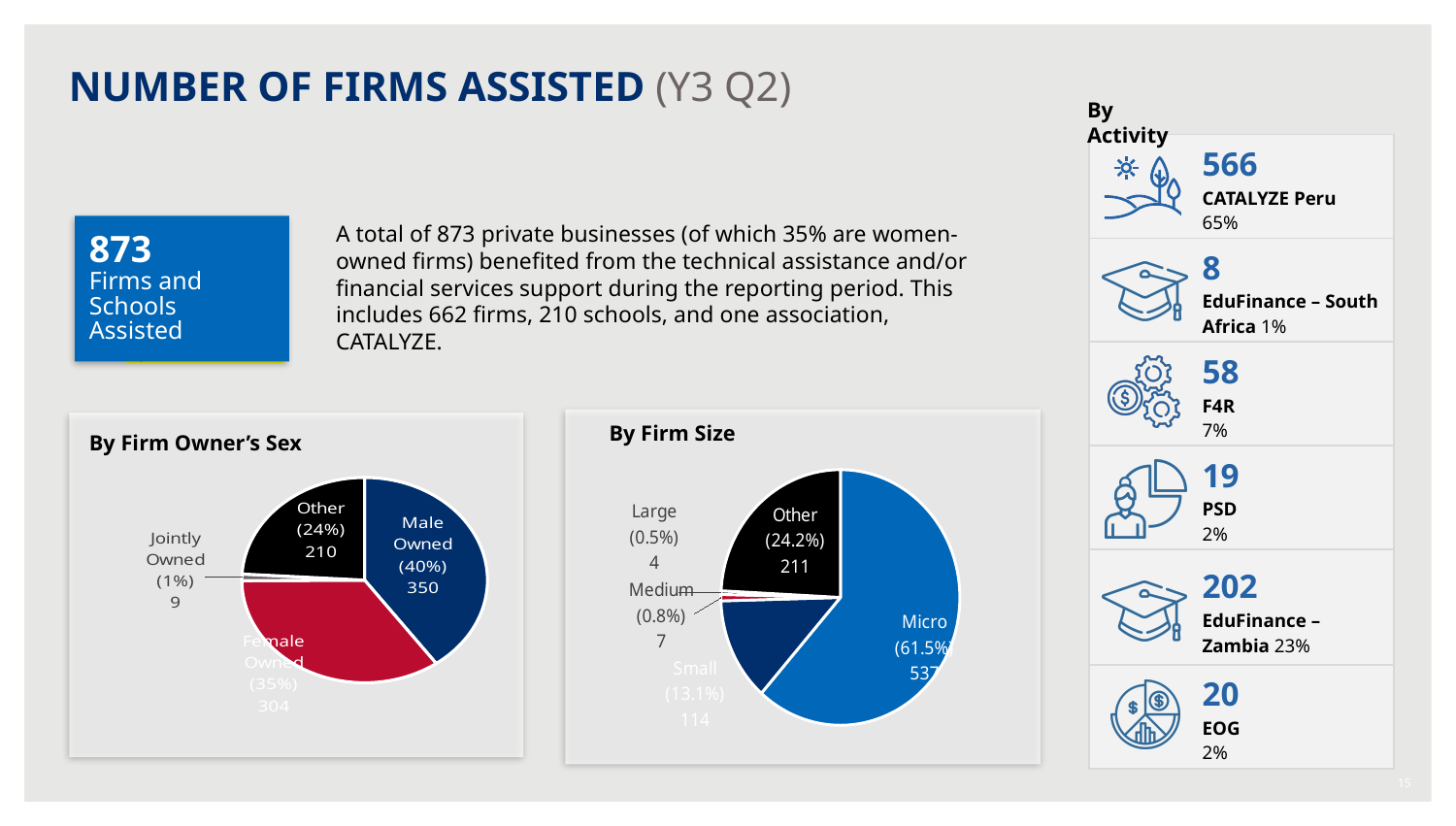
In the 'By Firm Owner's Sex' chart, how many firms are Male Owned? 350 In the 'By Firm Size' chart, how many firms are Micro? 537 In the 'By Firm Owner's Sex' chart, what is the difference between the Male Owned and Female Owned counts? 46 How many categories are shown in the 'By Firm Size' chart? 5 In the 'By Firm Owner's Sex' chart, which category has the largest slice? Male Owned How many categories are shown in the 'By Firm Owner's Sex' chart? 4 In the 'By Firm Size' chart, which is larger, Medium or Large? Medium In the 'By Firm Size' chart, which category has the smallest slice? Large In the 'By Firm Owner's Sex' chart, what share of the pie is Female Owned? 35% What type of chart is the 'By Firm Size' chart? Pie chart In the 'By Firm Size' chart, what share of the pie is Small? 13.1% In the 'By Firm Owner's Sex' chart, which category has the smallest slice? Jointly Owned